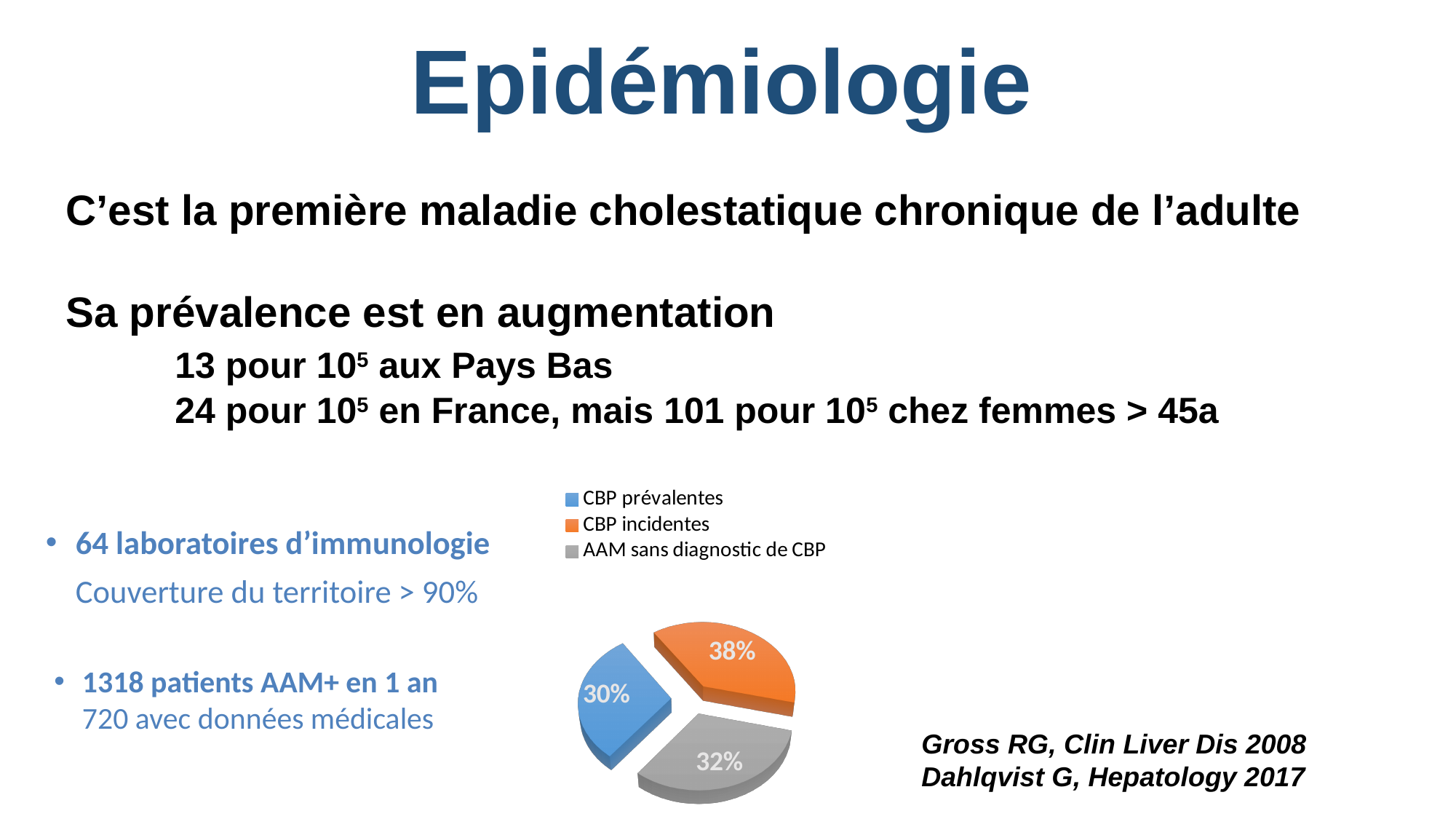
What kind of chart is shown on the slide? pie chart What is the difference in percentage points between the CBP incidentes slice and the CBP prévalentes slice? 8 What share of the pie is labelled AAM sans diagnostic de CBP? 32% How many slices does the pie chart have? 3 How many entries does the legend of the pie chart list? 3 What colour is the AAM sans diagnostic de CBP slice in the pie chart? grey Which slice of the pie chart is the smallest? CBP prévalentes Which slice of the pie chart is the largest? CBP incidentes Which is larger, the AAM sans diagnostic de CBP slice or the CBP prévalentes slice? AAM sans diagnostic de CBP What colour is the CBP incidentes slice in the pie chart? orange What share of the pie is labelled CBP incidentes? 38% What share of the pie is labelled CBP prévalentes? 30%